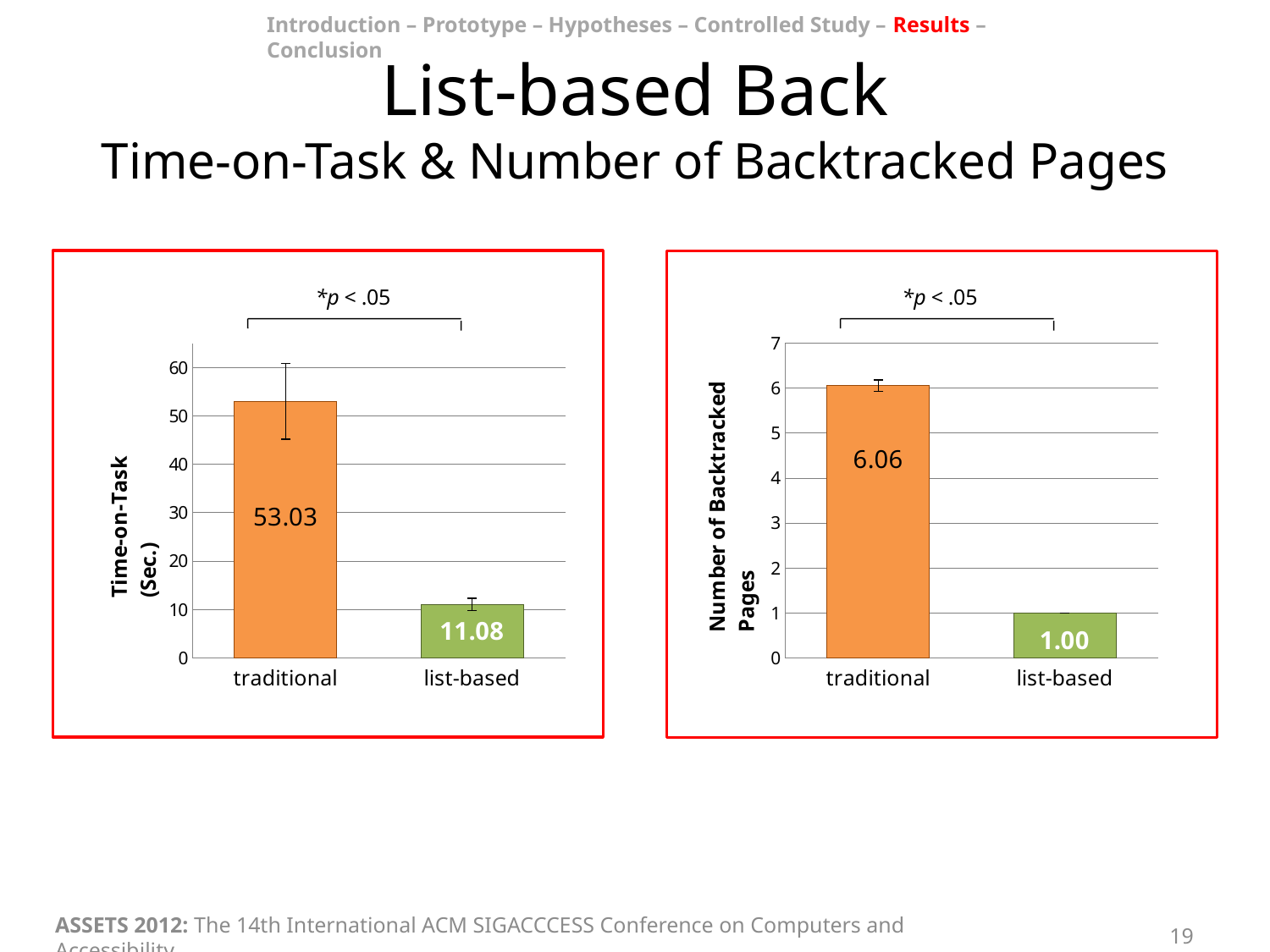
What is the y-axis label of the left chart? Time-on-Task (Sec.) How many categories are shown on the x axis of the left chart (Time-on-Task)? 2 In the right chart (Number of Backtracked Pages), what is the value for list-based? 1.00 In the right chart (Number of Backtracked Pages), which category has the lowest value? list-based In the right chart (Number of Backtracked Pages), is the value for traditional greater or less than 5? greater In the left chart (Time-on-Task), what is the value for list-based? 11.08 In the left chart (Time-on-Task), what is the value for traditional? 53.03 In the right chart (Number of Backtracked Pages), what is the value for traditional? 6.06 In the right chart (Number of Backtracked Pages), what is the difference between the traditional and list-based values? 5.06 What kind of chart is the right chart (Number of Backtracked Pages)? bar chart In the left chart (Time-on-Task), which category has the highest value? traditional In the left chart (Time-on-Task), what is the difference between the traditional and list-based values? 41.95